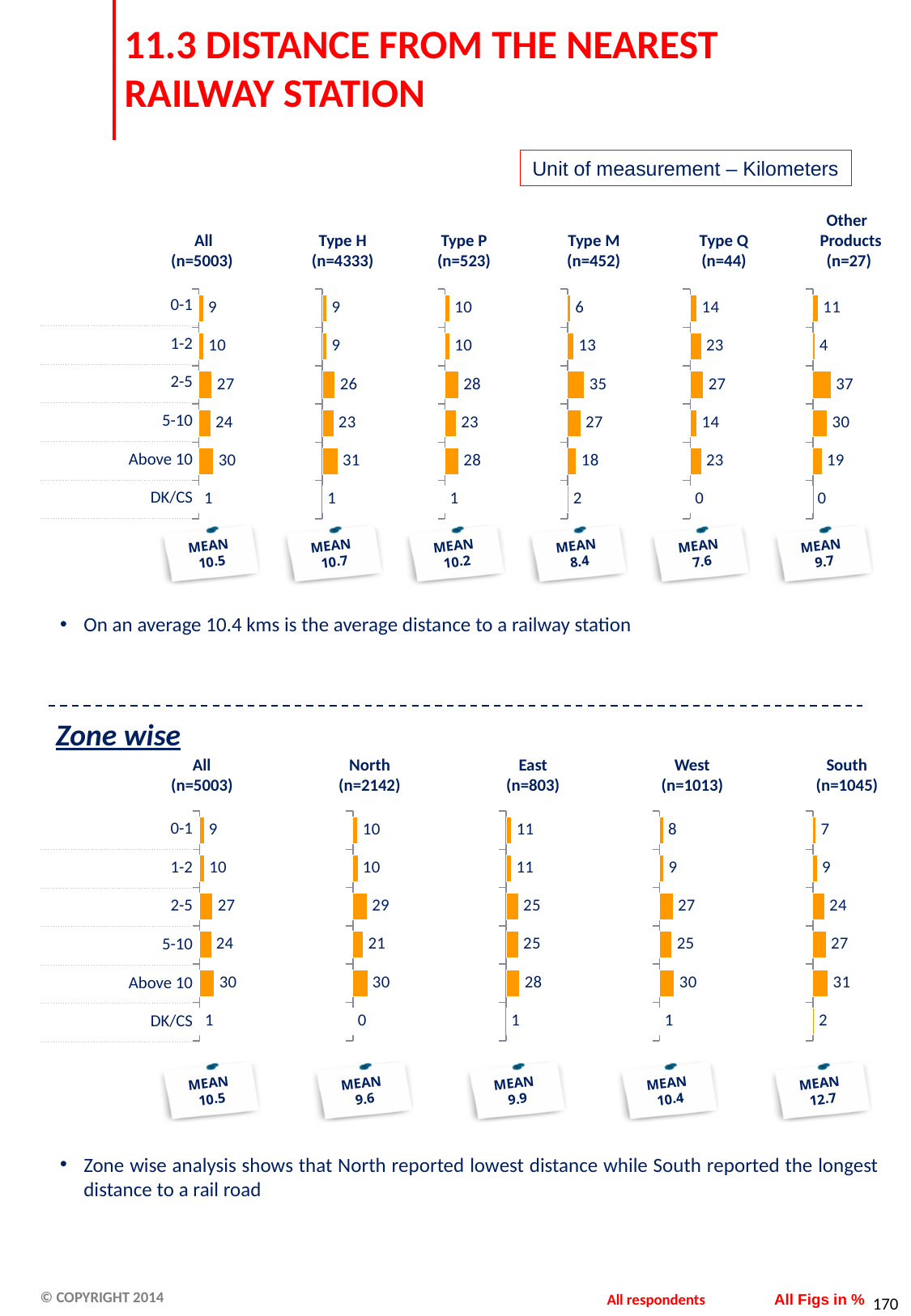
What type of chart is used to show the distance distributions on this slide? Bar chart In the top section (by product type), what is the value for the 2-5 km category in the Type M (n=452) chart? 35 In the Zone wise section, what is the value for Above 10 km in the South (n=1045) chart? 31 In the Zone wise section, what is the difference between the Above 10 km value and the 0-1 km value in the East (n=803) chart? 17 How many distance categories are shown in each chart on the slide? 6 In the top section, which distance category has the lowest value in the Type Q (n=44) chart? DK/CS In the top section, what is the value for Above 10 km in the Type H (n=4333) chart? 31 In the top section, what is the difference between the 2-5 km value and the 0-1 km value in the Type P (n=523) chart? 18 In the top section, which distance category has the highest value in the Other Products (n=27) chart? 2-5 In the Zone wise section, what is the value for 5-10 km in the North (n=2142) chart? 21 In the Zone wise section, which distance category has the highest value in the West (n=1013) chart? Above 10 In the top section, which is larger in the Type Q (n=44) chart: the 1-2 km value or the 5-10 km value? 1-2